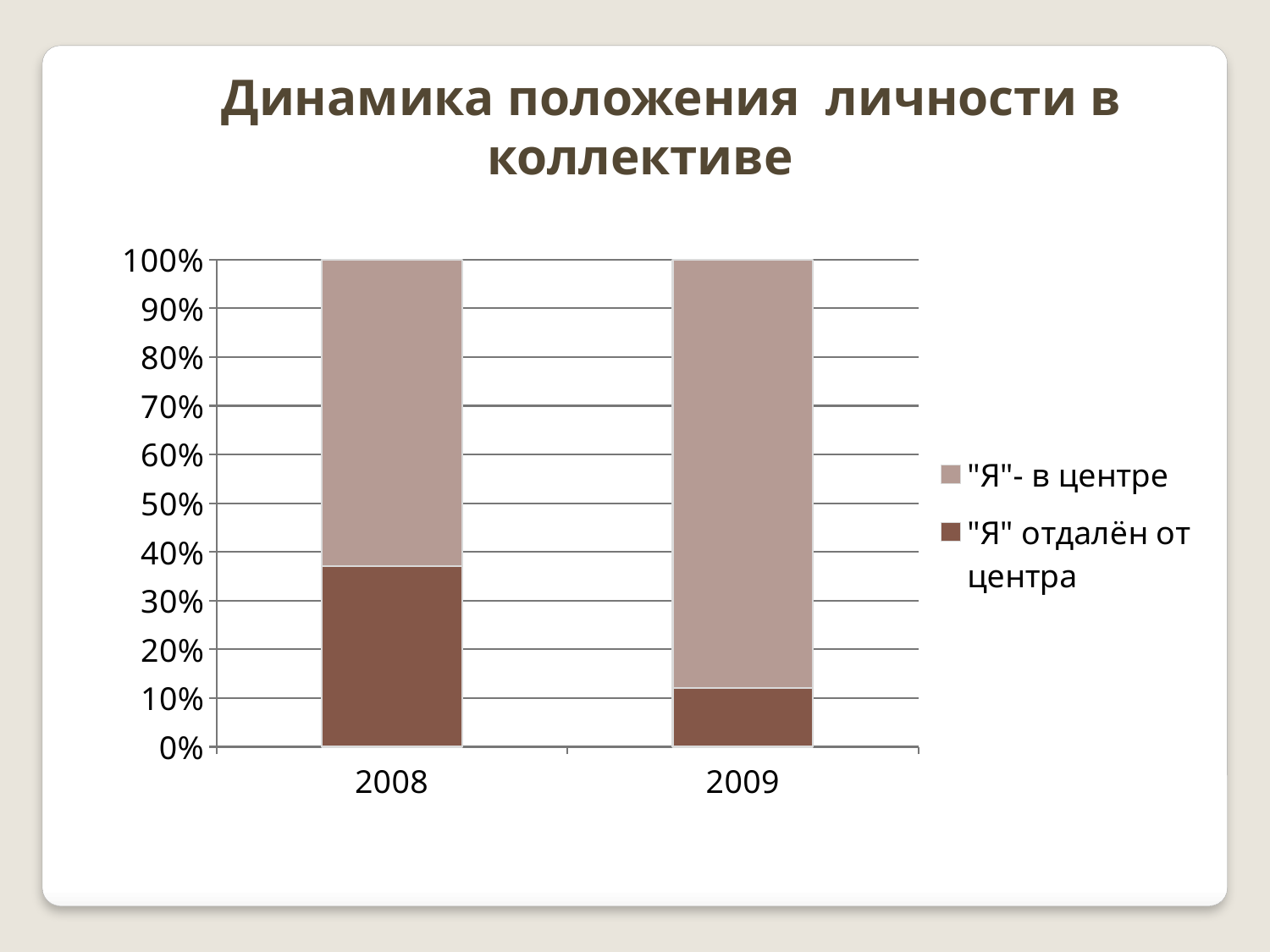
Is the value for "Я" отдалён от центра in 2008 greater or less than 30%? greater What is the title of the chart on the slide? Динамика положения личности в коллективе Is the value for "Я"- в центре in 2009 greater or less than 80%? greater How many categories are shown on the x axis? 2 Does the share for "Я"- в центре rise or fall from 2008 to 2009? rise Which years are shown on the x axis? 2008 and 2009 Which year has the larger share for "Я" отдалён от центра, 2008 or 2009? 2008 How many series does the legend list? 2 What kind of chart is shown on the slide? stacked bar chart Is the value for "Я"- в центре in 2008 greater or less than 70%? less What is the total height of the stacked bar for 2009? 100%